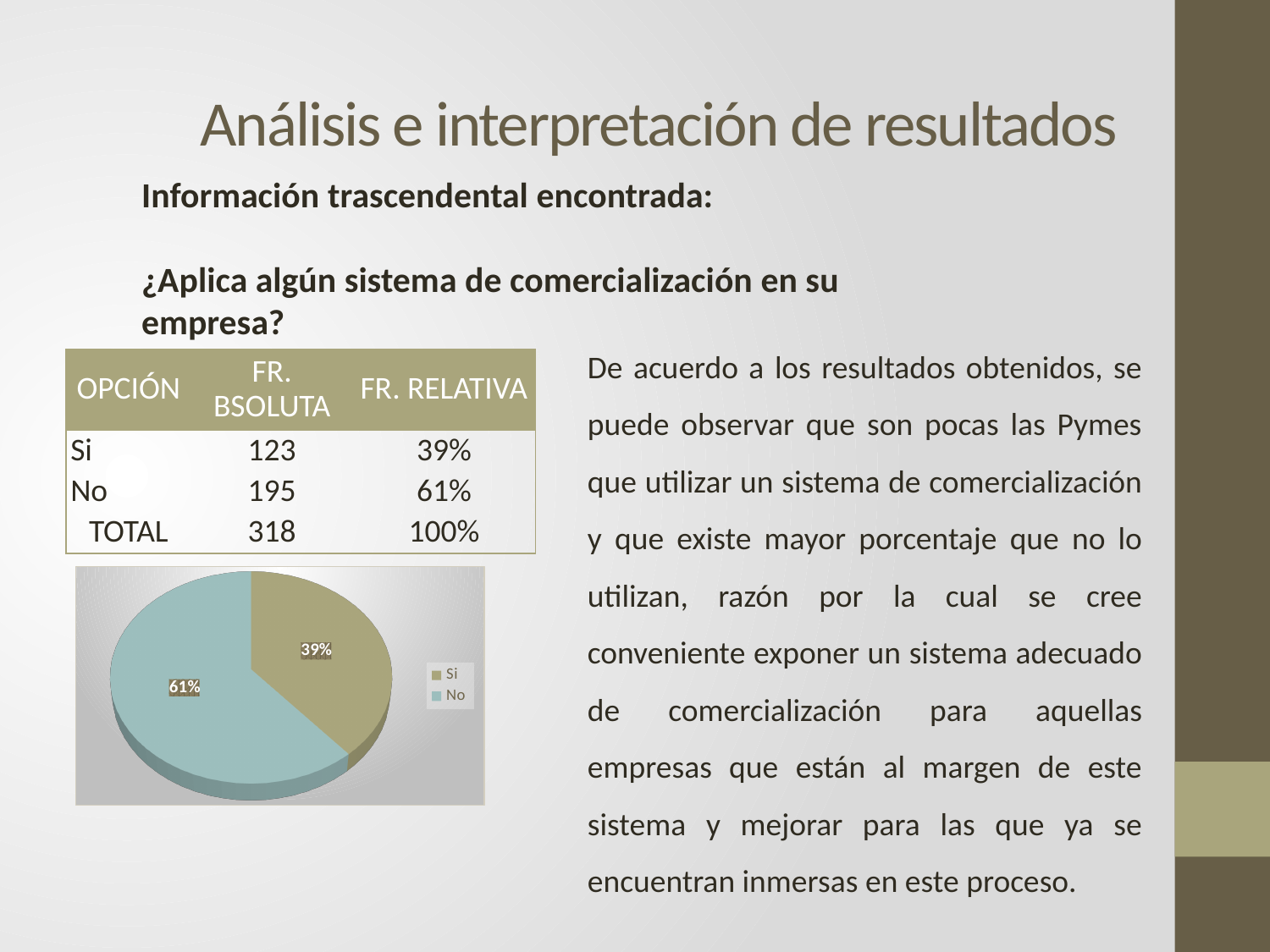
Which slice of the pie chart is the largest? No Which legend entry is shown in the khaki/olive colour? Si What share of the pie does the "No" slice represent? 61% Which legend entry is shown in the blue-green colour? No What share of the pie does the "Si" slice represent? 39% Which is larger in the pie chart, the "Si" slice or the "No" slice? No How many entries does the legend of the pie chart list? 2 What is the difference in percentage points between the "No" slice and the "Si" slice? 22% What kind of chart is shown on the slide? pie chart How many slices does the pie chart have? 2 Which slice of the pie chart is the smallest? Si